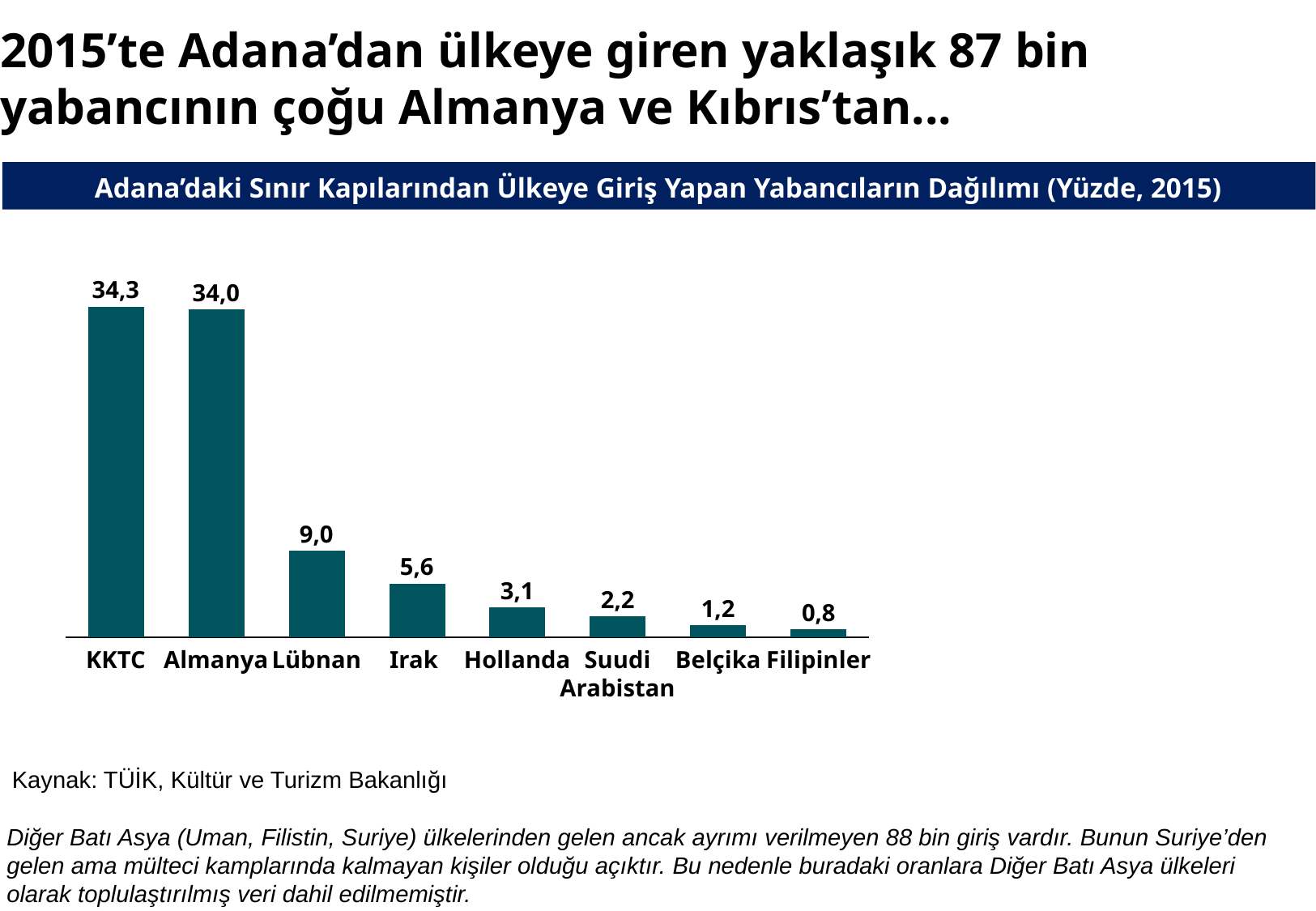
Which is larger, the value for Irak or the value for Hollanda? Irak What is the value for Suudi Arabistan? 2,2 What is the value for Belçika? 1,2 What kind of chart is shown on the slide? Bar chart Which category has the lowest value? Filipinler Do the values rise or fall from left to right along the x axis? Fall What is the value for Hollanda? 3,1 How many categories are shown in the chart? 8 What is the difference between the values for KKTC and Almanya? 0,3 What is the difference between the values for Lübnan and Irak? 3,4 Which category has the highest value? KKTC What is the value for Lübnan? 9,0